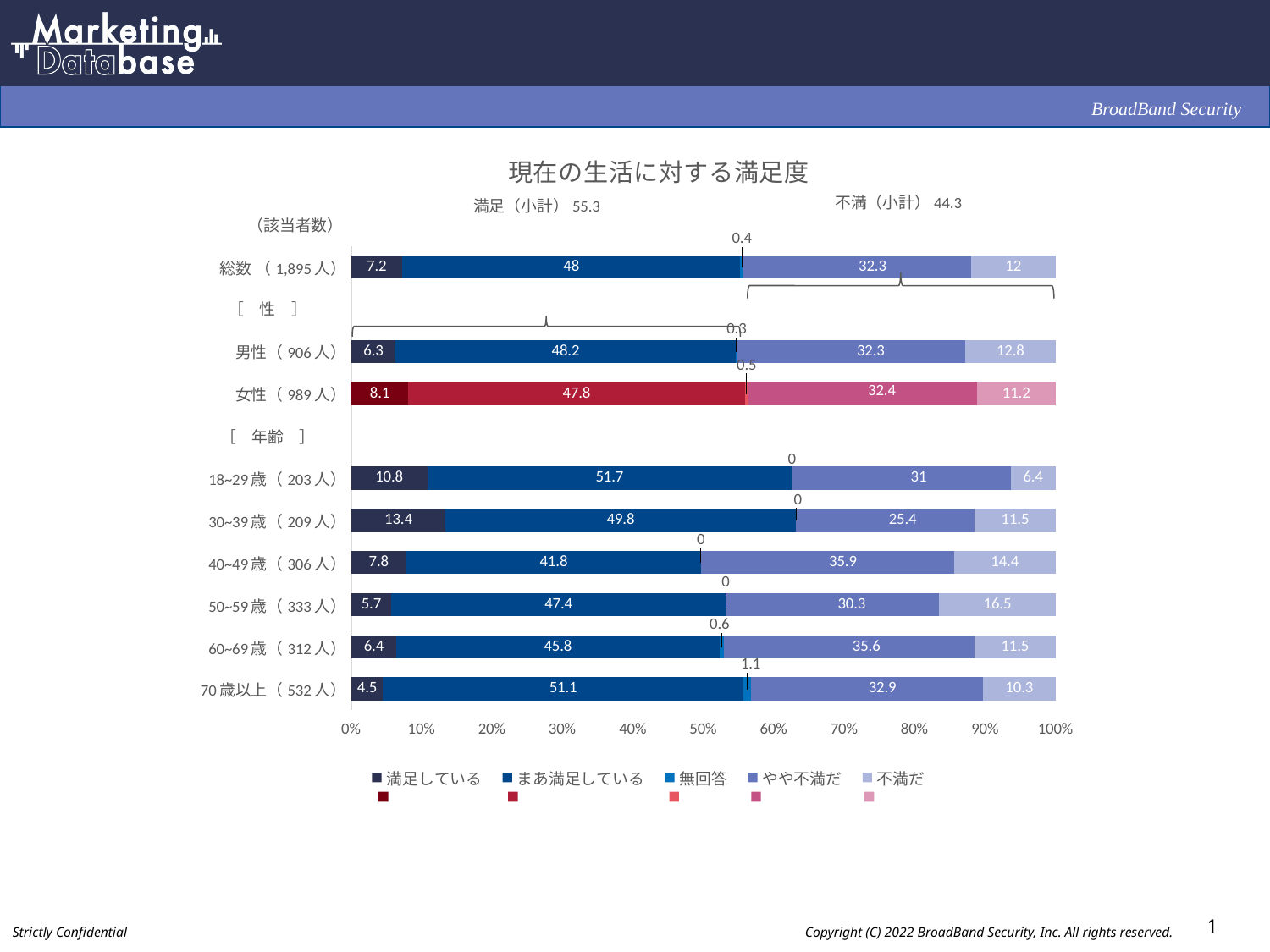
What type of chart is shown on the slide? Stacked bar chart What is the difference between the やや不満だ values for 40~49歳 and 30~39歳? 10.5 What is the value of 満足している for 総数? 7.2 How many categories (bars) are plotted in the chart? 9 Which is larger, the 満足している value for 男性 or for 女性? 女性 What is the 満足（小計） value shown above the chart? 55.3 What is the value of 不満だ for 50~59歳? 16.5 Which category has the highest value for 満足している? 30~39歳 What is the value of 無回答 for 70歳以上? 1.1 How many series does the legend list? 5 Which category has the lowest value for 不満だ? 18~29歳 What is the value of まあ満足している for 18~29歳? 51.7